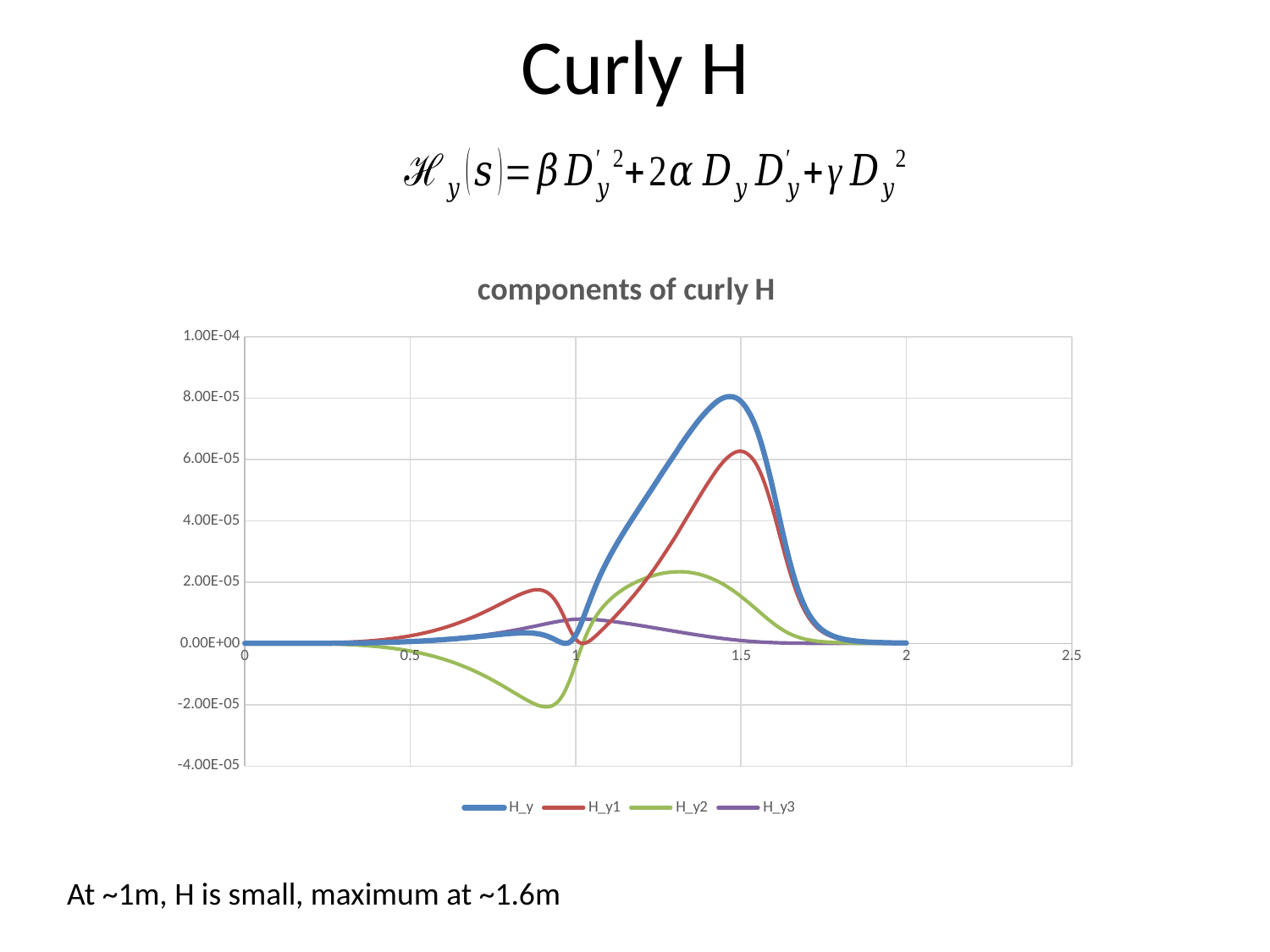
What is the title of the chart? components of curly H Between x = 1 and x = 1.5, does the H_y series rise or fall? rise Is the peak value of the H_y series greater or less than 6.00E-05? greater Which series has the larger peak value, H_y or H_y1? H_y Is the peak value of the H_y3 series greater or less than 2.00E-05? less How many series does the legend of the chart list? 4 Which series in the chart dips to the lowest (most negative) value? H_y2 Which series in the chart reaches the highest peak value? H_y What kind of chart is shown on the slide? line chart Is the peak value of the H_y1 series greater or less than 4.00E-05? greater Which series is drawn in green in the chart? H_y2